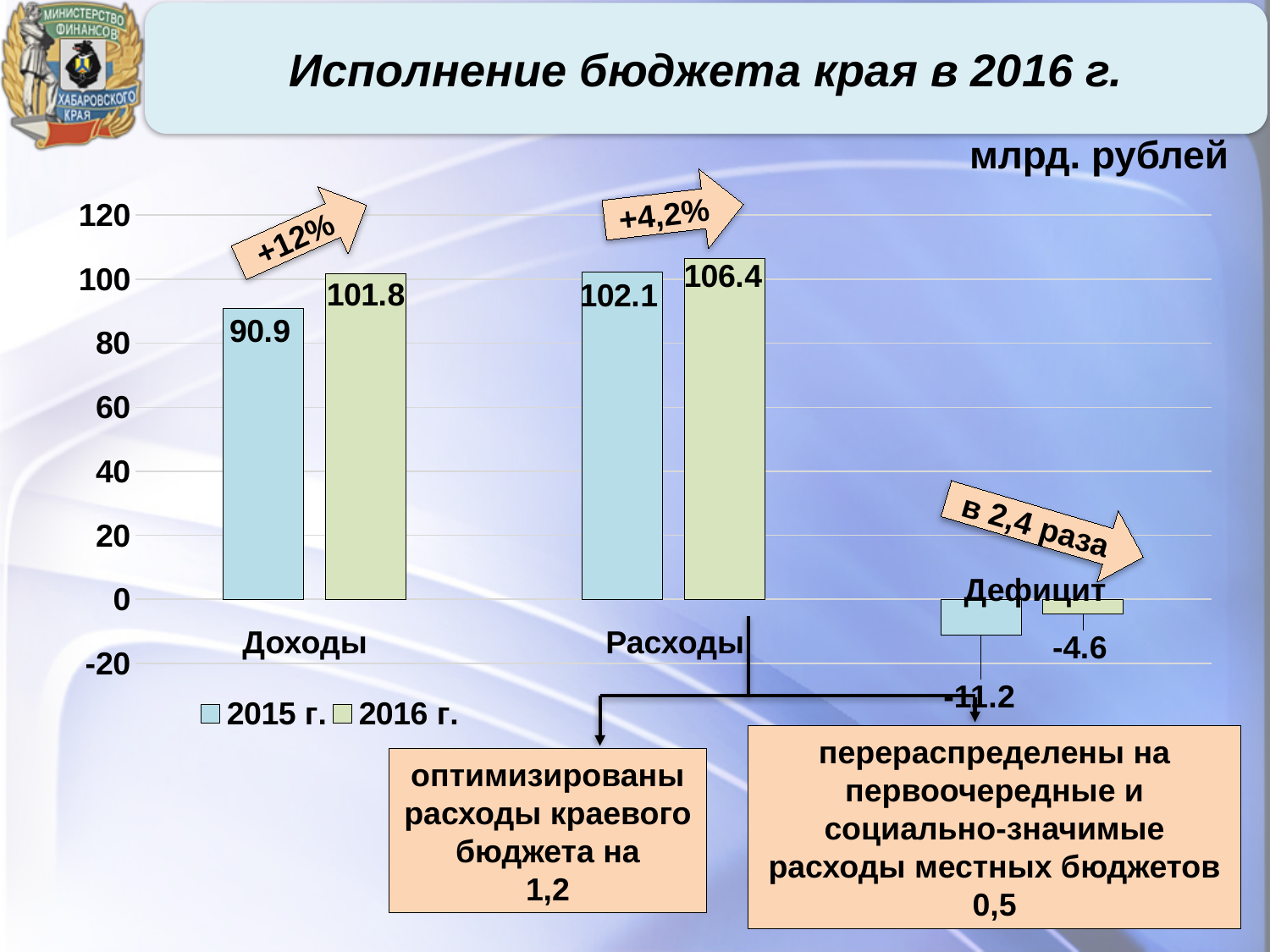
What is the value for Доходы in 2016 г.? 101.8 How many categories are shown on the x axis? 3 What kind of chart is shown on the slide? Bar chart Which category has the highest value in the 2016 г. series? Расходы What is the value for Расходы in 2016 г.? 106.4 What is the value for Дефицит in 2015 г.? -11.2 How many series does the legend list? 2 What is the value for Дефицит in 2016 г.? -4.6 Which is larger: Расходы in 2015 г. or Доходы in 2016 г.? Расходы in 2015 г. Which category has the lowest value in the 2015 г. series? Дефицит What is the value for Доходы in 2015 г.? 90.9 What is the difference between Доходы in 2016 г. and Доходы in 2015 г.? 10.9